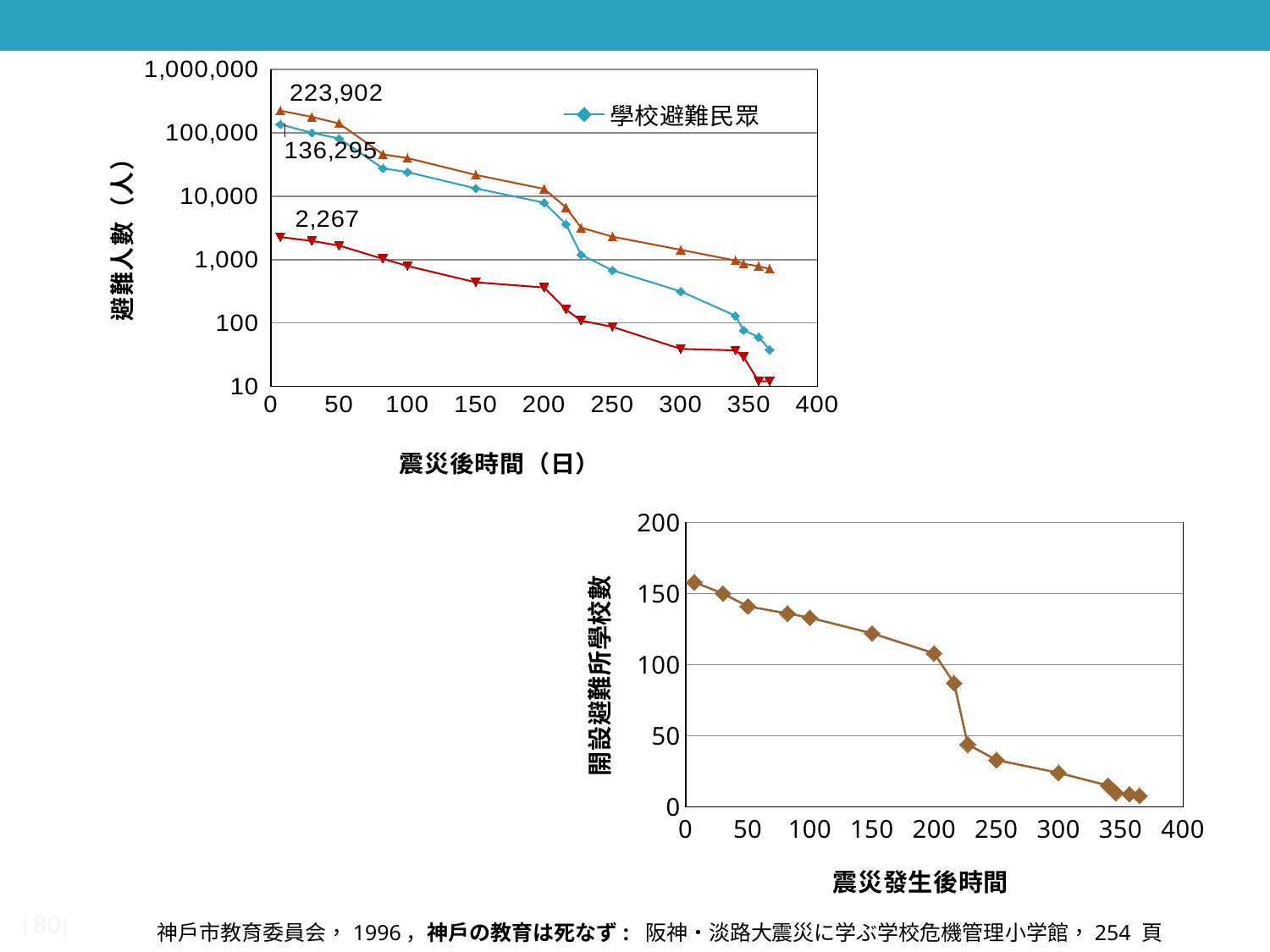
In the top chart, what is the difference between the labelled starting values 223,902 and 136,295? 87,607 In the top chart, what is the labelled starting value of the topmost (triangle-marker) series? 223,902 In the top chart, which is larger at the start: the topmost series (223,902) or the 學校避難民眾 series (136,295)? the topmost series (223,902) In the top chart, what is the labelled starting value of the 學校避難民眾 series? 136,295 In the bottom chart, is the value at 250 days greater or less than 50? less In the top chart, is the value of the 學校避難民眾 series at 300 days greater or less than 1,000? less What is the y-axis label of the bottom chart? 開設避難所學校數 What type of chart is the top chart on the slide? line chart In the top chart, do the values rise or fall as time after the earthquake increases? fall In the bottom chart, is the value at the first point (near 0 days) greater or less than 150? greater In the top chart, what is the labelled starting value of the lowest (inverted-triangle) series? 2,267 How many series does the legend of the top chart list? 1